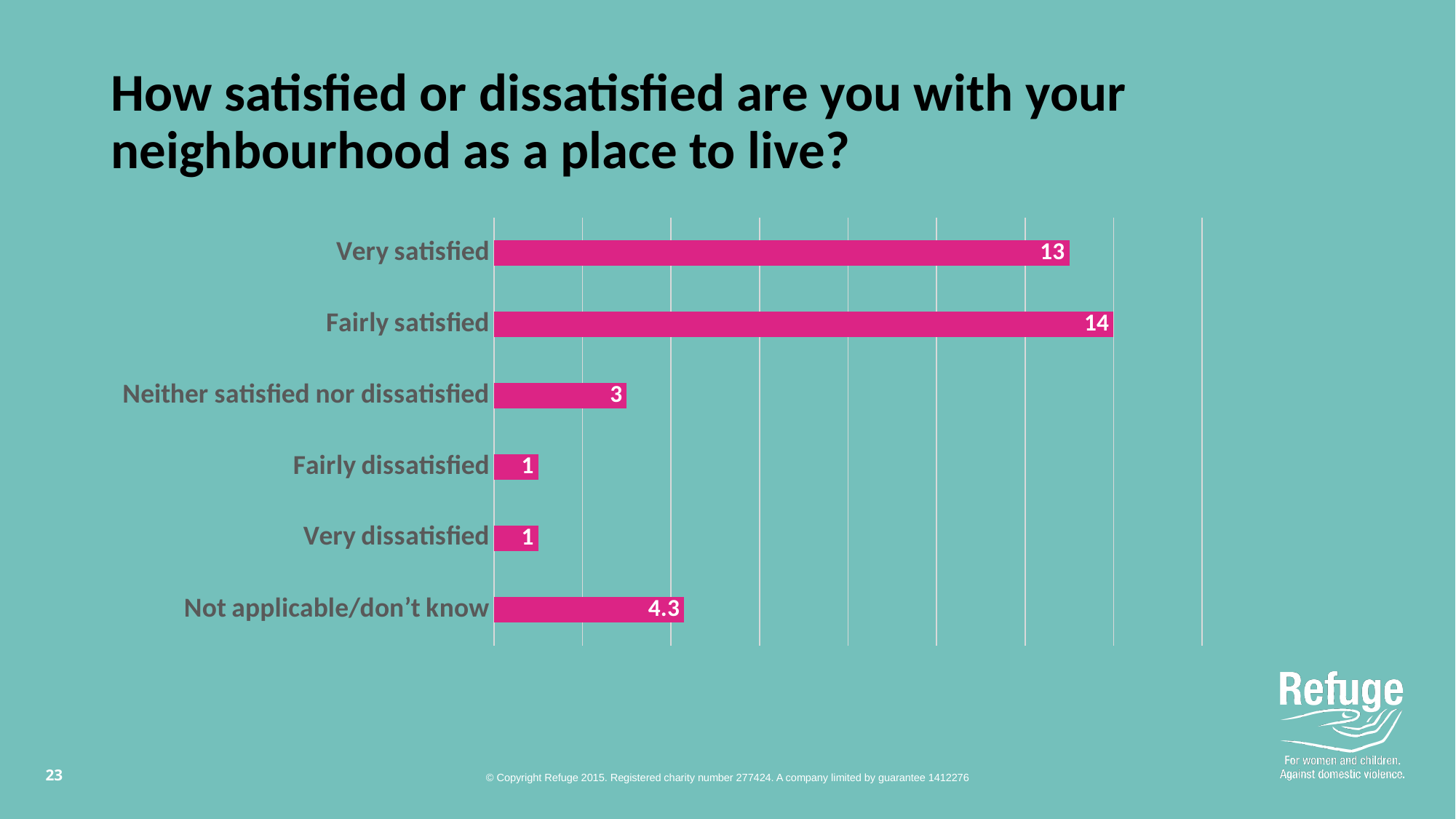
What is the value for Neither satisfied nor dissatisfied? 3 What is the difference between the values for Fairly satisfied and Very satisfied? 1 What is the value for Fairly dissatisfied? 1 Which category has the highest value? Fairly satisfied What kind of chart is shown on the slide? Bar chart What is the value for Very satisfied? 13 What is the value for Fairly satisfied? 14 What is the value for Not applicable/don't know? 4.3 Which is larger, the value for Neither satisfied nor dissatisfied or the value for Not applicable/don't know? Not applicable/don't know How many categories are shown in the chart? 6 What colour are the bars in the chart? Pink What is the difference between the values for Not applicable/don't know and Neither satisfied nor dissatisfied? 1.3